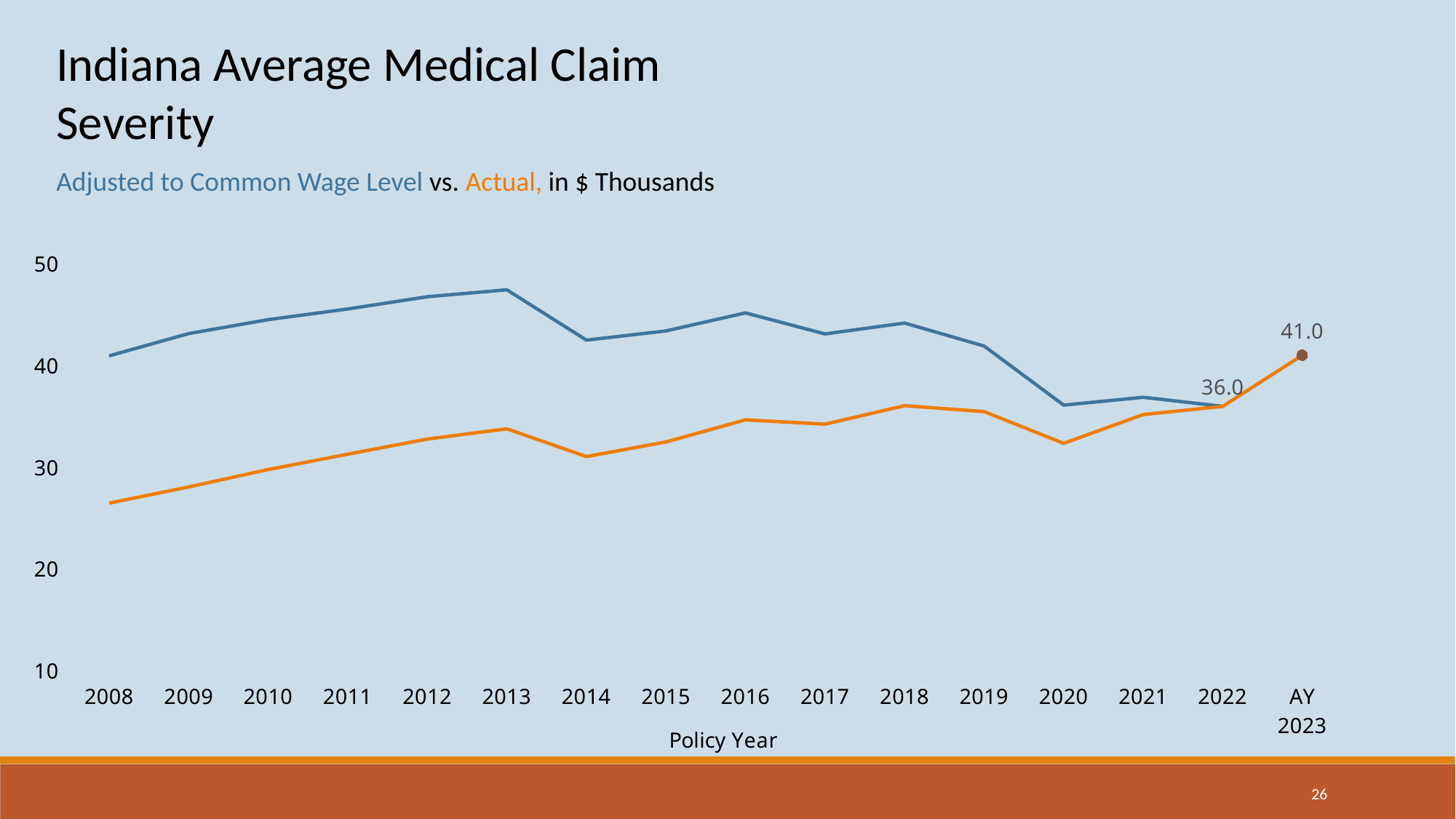
What is the Actual average medical claim severity for AY 2023? 41.0 How many policy years are shown along the x axis? 16 How many data series are plotted on the chart? 2 In 2014, which series has the higher value, Adjusted to Common Wage Level or Actual? Adjusted to Common Wage Level What is the title of the x axis? Policy Year Is the Actual value for 2008 greater or less than 30? less In which policy year is the Actual line at its lowest? 2008 By how much does the Actual value for AY 2023 exceed the Actual value for 2022? 5.0 What kind of chart is shown on the slide? line chart What is the Actual average medical claim severity for policy year 2022? 36.0 In which policy year does the Adjusted to Common Wage Level line reach its highest point? 2013 Is the Adjusted to Common Wage Level value for 2013 greater or less than 45? greater